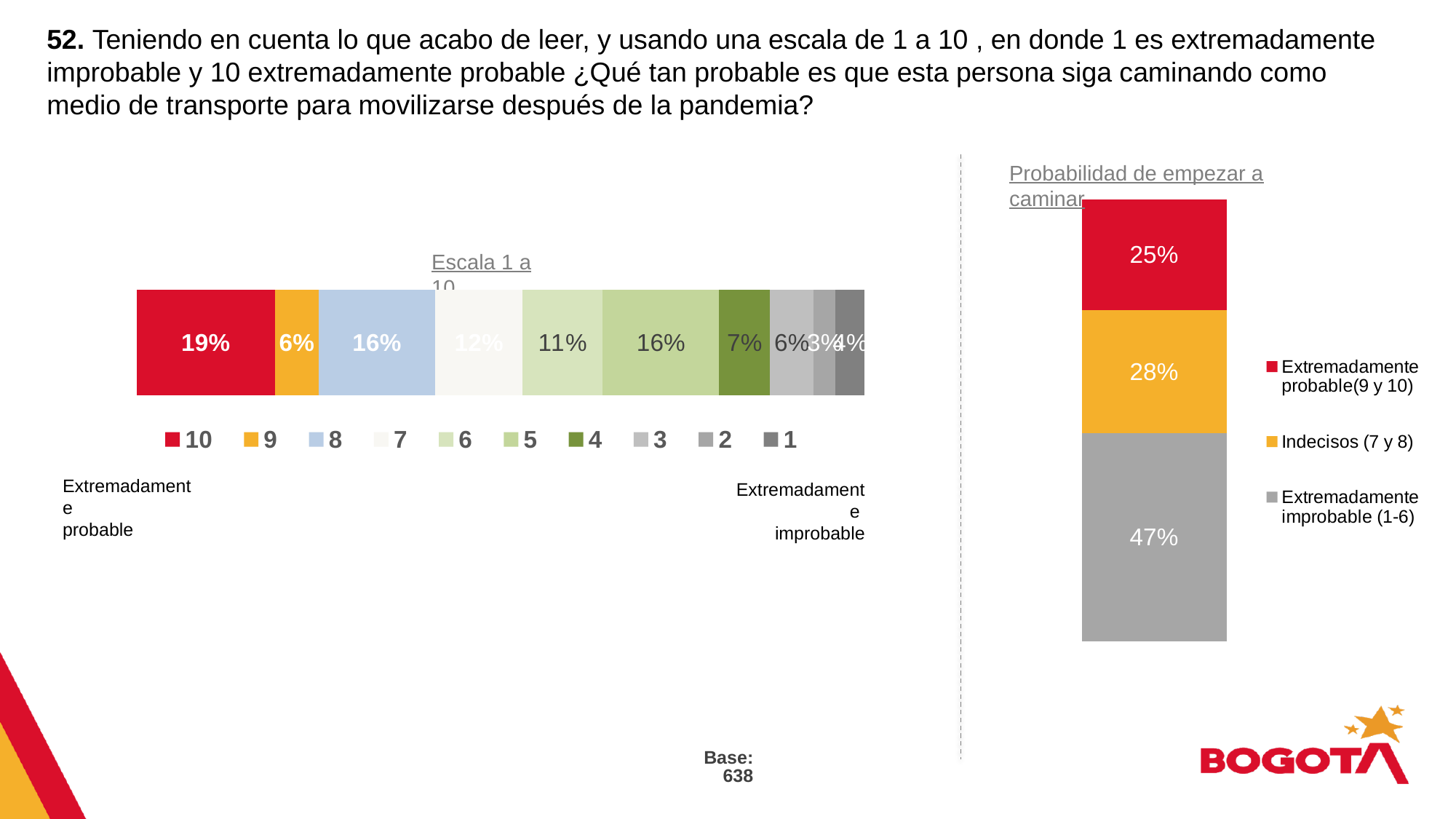
In the 'Probabilidad de empezar a caminar' chart, what percentage is shown for 'Extremadamente improbable (1-6)'? 47% In the 'Probabilidad de empezar a caminar' chart, which is larger: 'Indecisos (7 y 8)' or 'Extremadamente probable(9 y 10)'? Indecisos (7 y 8) In the 'Escala 1 a 10' chart, what percentage is shown for the value 8? 16% In the 'Probabilidad de empezar a caminar' chart, which segment is the smallest? Extremadamente probable(9 y 10) In the 'Escala 1 a 10' chart, what percentage is shown for the value 4? 7% What kind of chart is the 'Probabilidad de empezar a caminar' chart? Stacked bar chart In the 'Escala 1 a 10' chart, what percentage is shown for the value 10? 19% In the 'Escala 1 a 10' chart, what is the difference between the percentages for 10 and 9? 13% In the 'Probabilidad de empezar a caminar' chart, what percentage is shown for 'Indecisos (7 y 8)'? 28% In the 'Escala 1 a 10' chart, what percentage is shown for the value 7? 12% In the 'Escala 1 a 10' chart, which scale value has the highest percentage? 10 In the 'Escala 1 a 10' chart, how many series does the legend list? 10